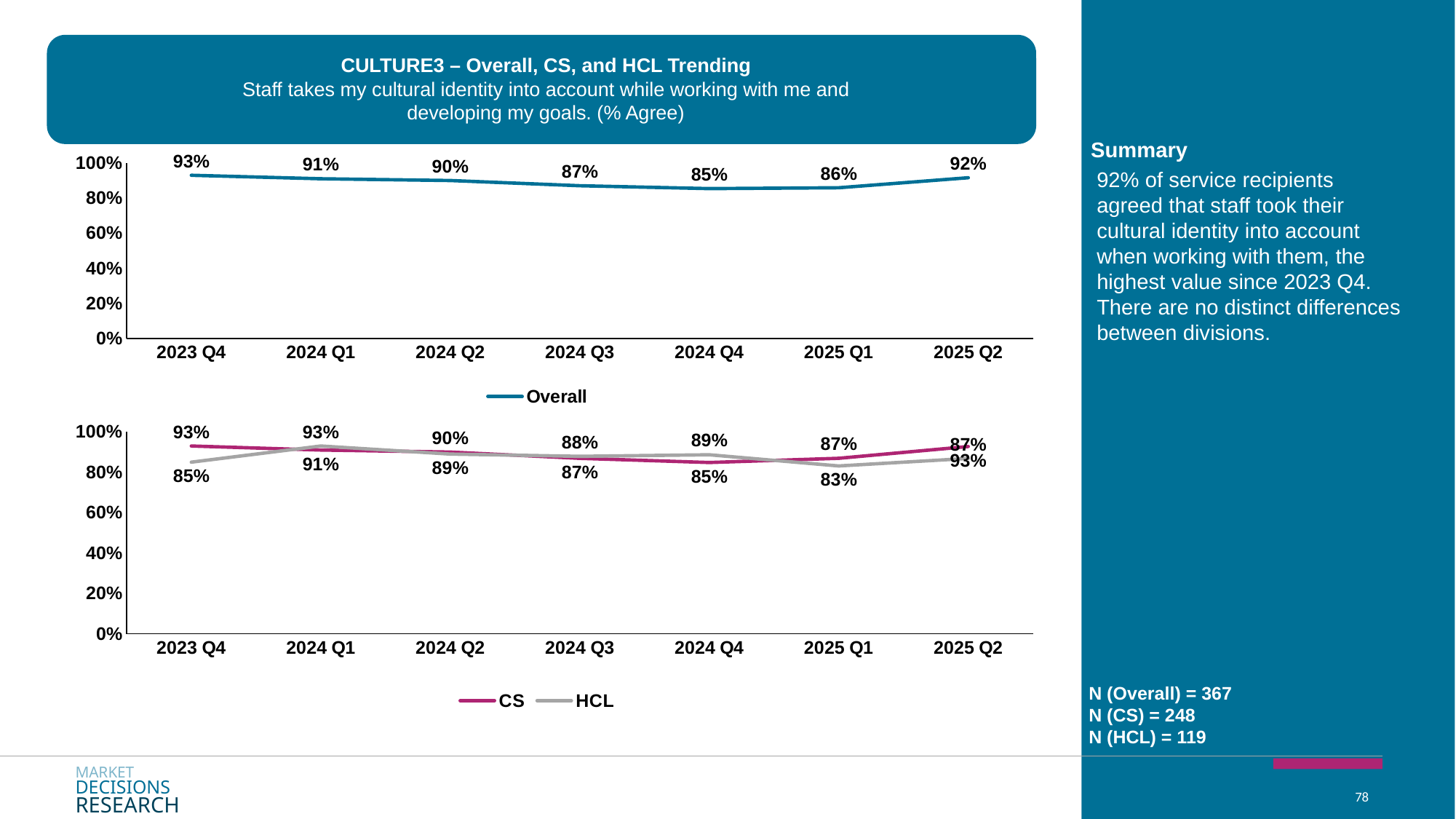
In the bottom chart, what is the HCL value for 2023 Q4? 85% In the bottom chart, which series has the higher value in 2024 Q4, CS or HCL? HCL How many series does the legend of the bottom chart list? 2 In the top chart (Overall), what is the difference between the 2023 Q4 value and the 2024 Q4 value? 8 percentage points What kind of chart is the top chart (Overall)? Line chart In the top chart (Overall), what is the value for 2024 Q3? 87% In the top chart (Overall), which quarter has the lowest value? 2024 Q4 In the bottom chart, what is the HCL value for 2025 Q1? 83% In the top chart (Overall), do the values rise or fall from 2023 Q4 to 2024 Q4? Fall In the top chart (Overall), which quarter has the highest value? 2023 Q4 In the top chart (Overall), how many quarters are plotted along the x axis? 7 In the bottom chart, what is the CS value for 2023 Q4? 93%